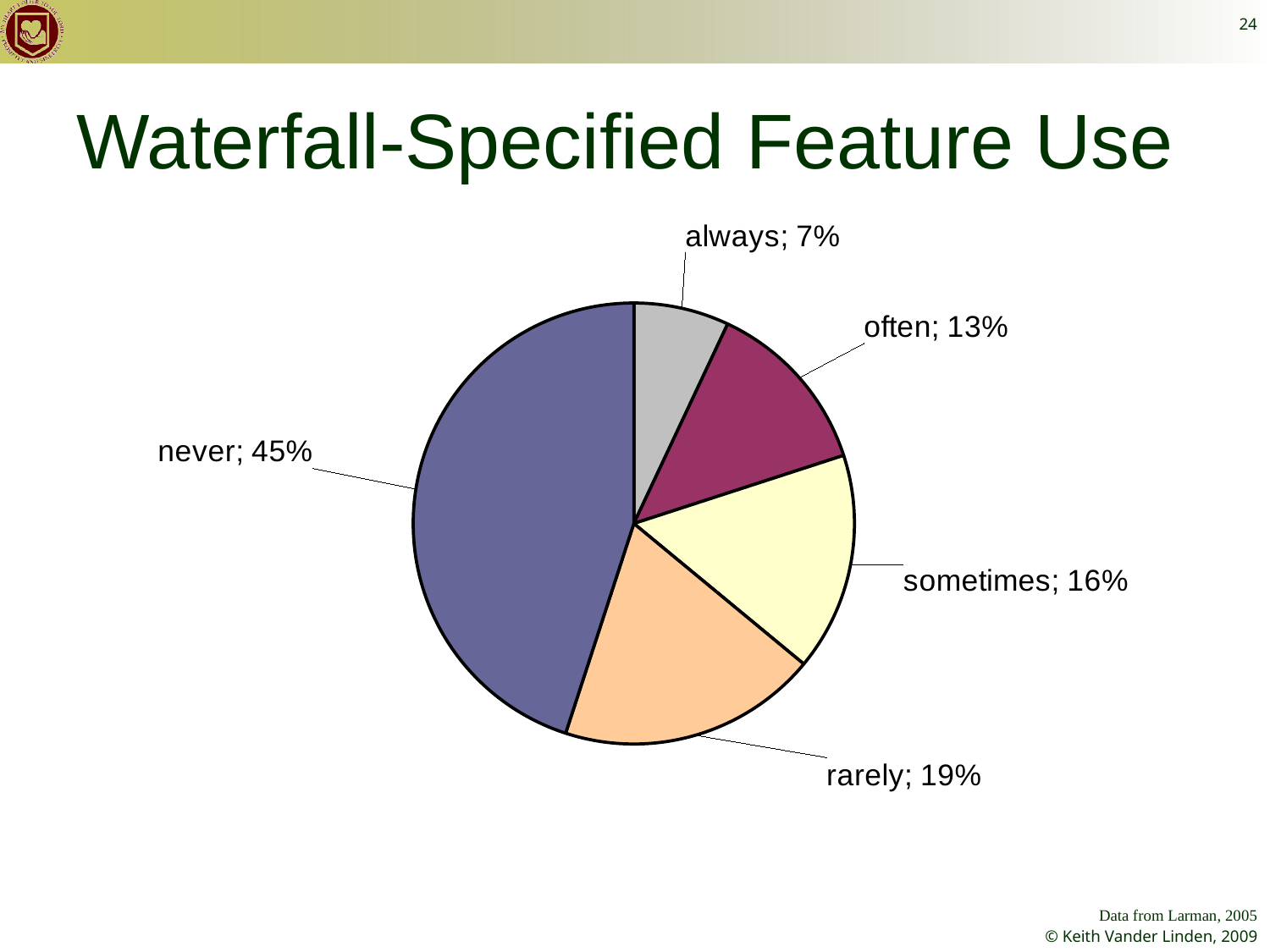
What is the difference in percentage points between the "never" slice and the "rarely" slice? 26 What kind of chart is shown on the slide? pie chart What percentage of the pie is labelled "often"? 13% Which slice is larger, "sometimes" or "often"? sometimes Which category has the largest slice of the pie? never Which category has the smallest slice of the pie? always What percentage of the pie is labelled "always"? 7% What percentage of the pie is labelled "never"? 45% What percentage of the pie is labelled "sometimes"? 16% What is the title of the chart on the slide? Waterfall-Specified Feature Use How many slices does the pie chart have? 5 What percentage of the pie is labelled "rarely"? 19%